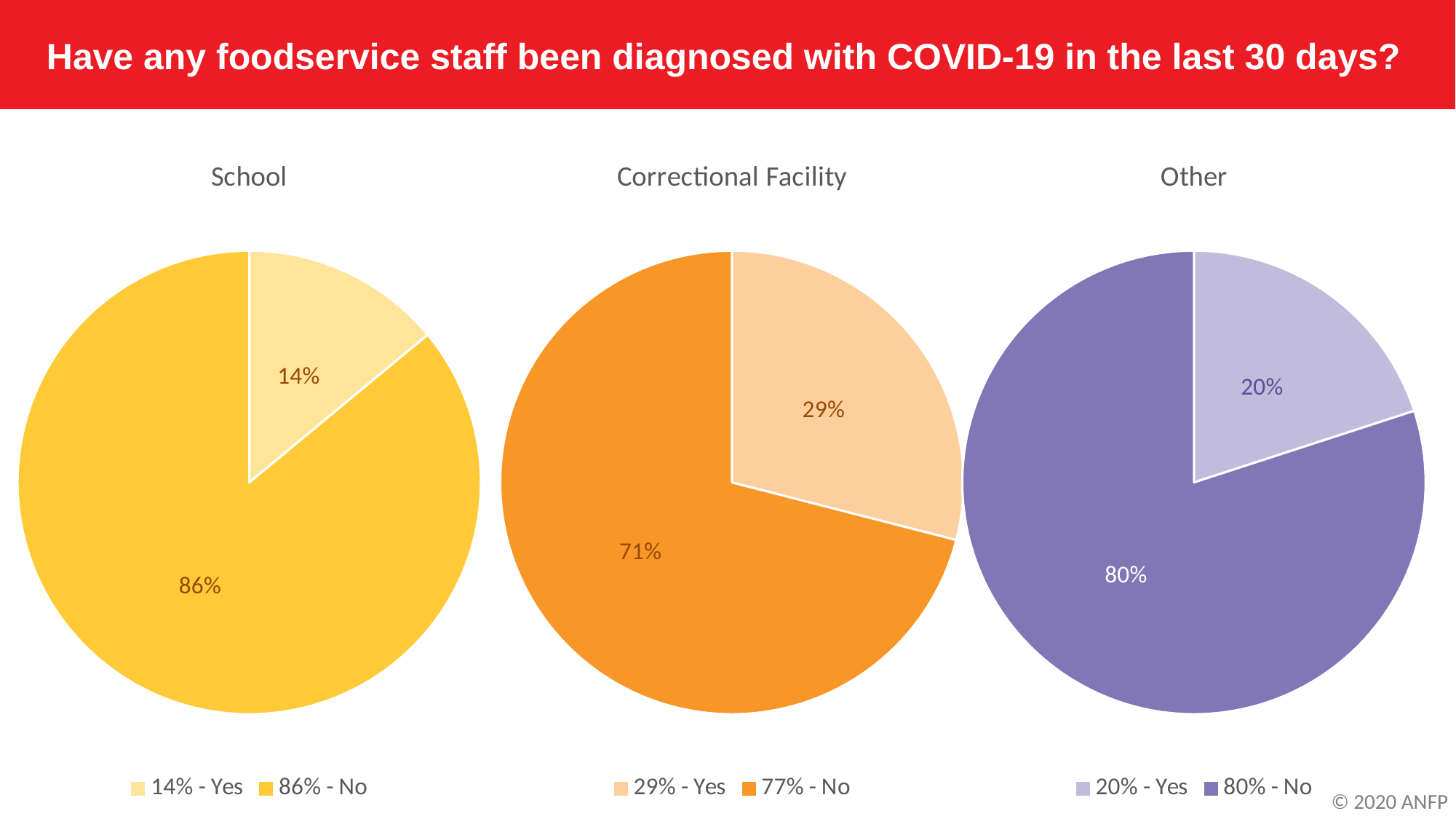
Is the Yes share in the Correctional Facility chart larger or smaller than the Yes share in the Other chart? Larger What kind of chart is used on this slide? Pie chart In the School chart, what share of respondents answered Yes? 14% Which chart has the smallest Yes share: School, Correctional Facility, or Other? School Which chart has the largest Yes share: School, Correctional Facility, or Other? Correctional Facility In the School chart, how many slices does the pie have? 2 How many pie charts are shown on the slide? 3 In the Other chart, what share of respondents answered Yes? 20% In the Correctional Facility chart, what share of respondents answered Yes? 29% In the School chart, what share of respondents answered No? 86% In the School chart, what is the difference between the No share and the Yes share? 72% In the Other chart, what share of respondents answered No? 80%